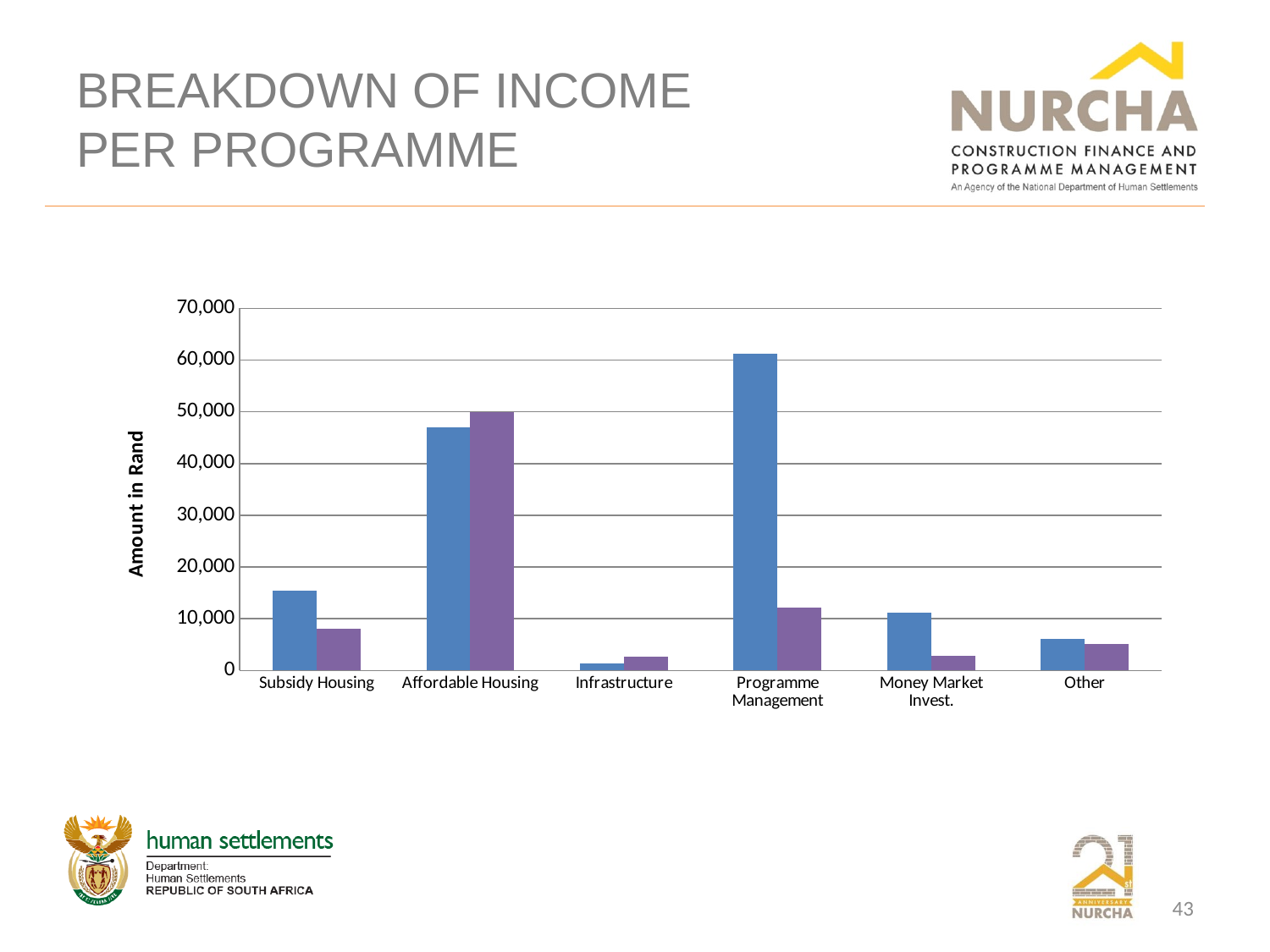
What kind of chart is shown on the slide? bar chart For Affordable Housing, which bar is taller, the blue one or the purple one? purple What is the label of the vertical axis of the chart? Amount in Rand How many bars are shown for each category in the chart? 2 How many categories are shown on the x axis of the chart? 6 Is the blue bar for Affordable Housing greater or less than 50,000? less For Subsidy Housing, which bar is taller, the blue one or the purple one? blue Which category has the tallest purple bar? Affordable Housing Which category has the tallest blue bar? Programme Management Is the purple bar for Subsidy Housing greater or less than 10,000? less Is the blue bar for Programme Management greater or less than 50,000? greater Which category has the shortest blue bar? Infrastructure